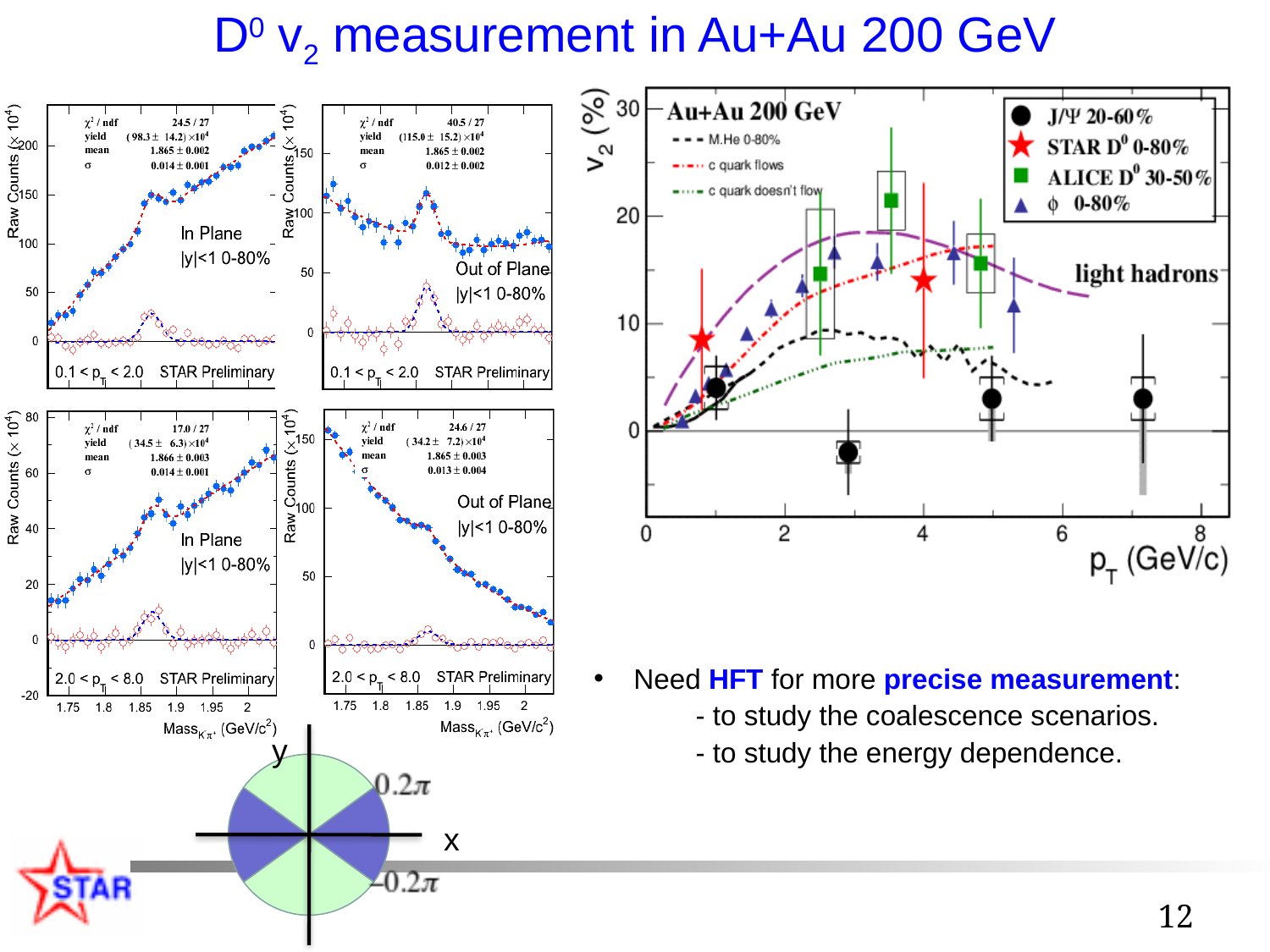
In the v2 versus pT chart on the right, how many ALICE D0 (green square) data points are plotted? 3 In the v2 versus pT chart on the right, which of the three ALICE D0 points has the highest v2: the one at pT of about 2.5, 3.5 or 5 GeV/c? about 3.5 GeV/c In the v2 versus pT chart on the right, how many STAR D0 (red star) data points are plotted? 2 In the bottom-left mass spectrum (In Plane, 2.0 < pT < 8.0), what is the fitted mean printed in the fit box? 1.866 ± 0.003 In the top-right mass spectrum (Out of Plane, 0.1 < pT < 2.0), what is the χ²/ndf printed in the fit box? 40.5 / 27 In the v2 versus pT chart on the right, is the STAR D0 value at pT of about 4 GeV/c greater or less than 10? greater In the v2 versus pT chart on the right, is the STAR D0 value at pT of about 1 GeV/c greater or less than 10? less What kind of chart is the large plot on the right of the slide (v2 versus pT)? scatter plot In the v2 versus pT chart on the right, is the J/Ψ value at pT of about 3 GeV/c greater or less than 0? less In the v2 versus pT chart on the right, what is the label of the y axis? v2 (%) In the top-left mass spectrum (In Plane, 0.1 < pT < 2.0), what is the fitted yield printed in the fit box? (98.3 ± 14.2)×10^4 In the v2 versus pT chart on the right, how many entries does the legend box list? 4